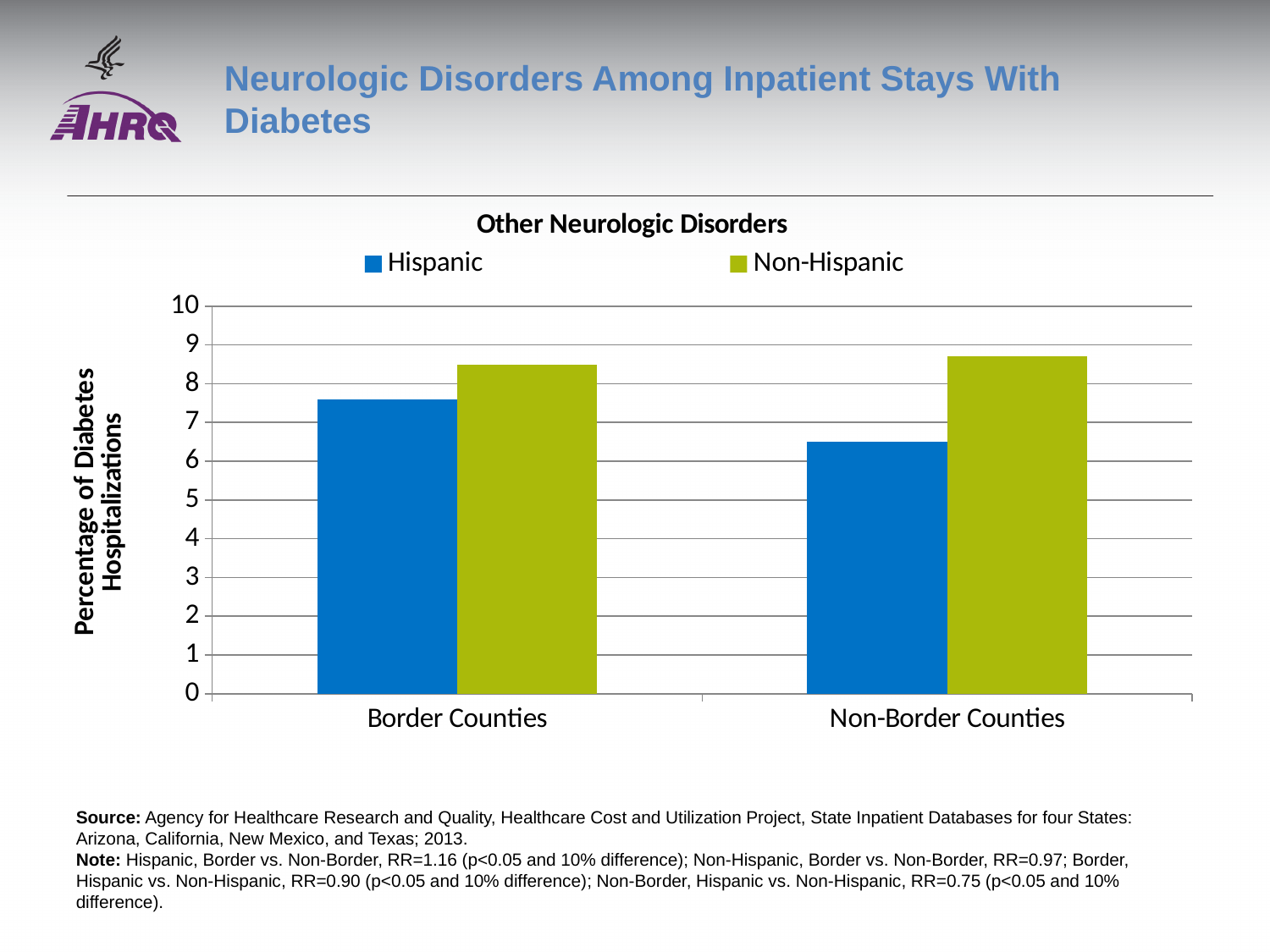
How many series does the legend list? 2 What type of chart is shown on the slide? Bar chart Is the Non-Hispanic value for Non-Border Counties greater or less than 8? greater Is the Non-Hispanic value for Border Counties greater or less than 8? greater Is the Hispanic value for Border Counties greater or less than 8? less What is the title of the chart? Other Neurologic Disorders What is the y-axis label of the chart? Percentage of Diabetes Hospitalizations Which bar has the lowest value in the chart? Hispanic, Non-Border Counties In Border Counties, which group has the higher value, Hispanic or Non-Hispanic? Non-Hispanic How many categories are shown on the x axis? 2